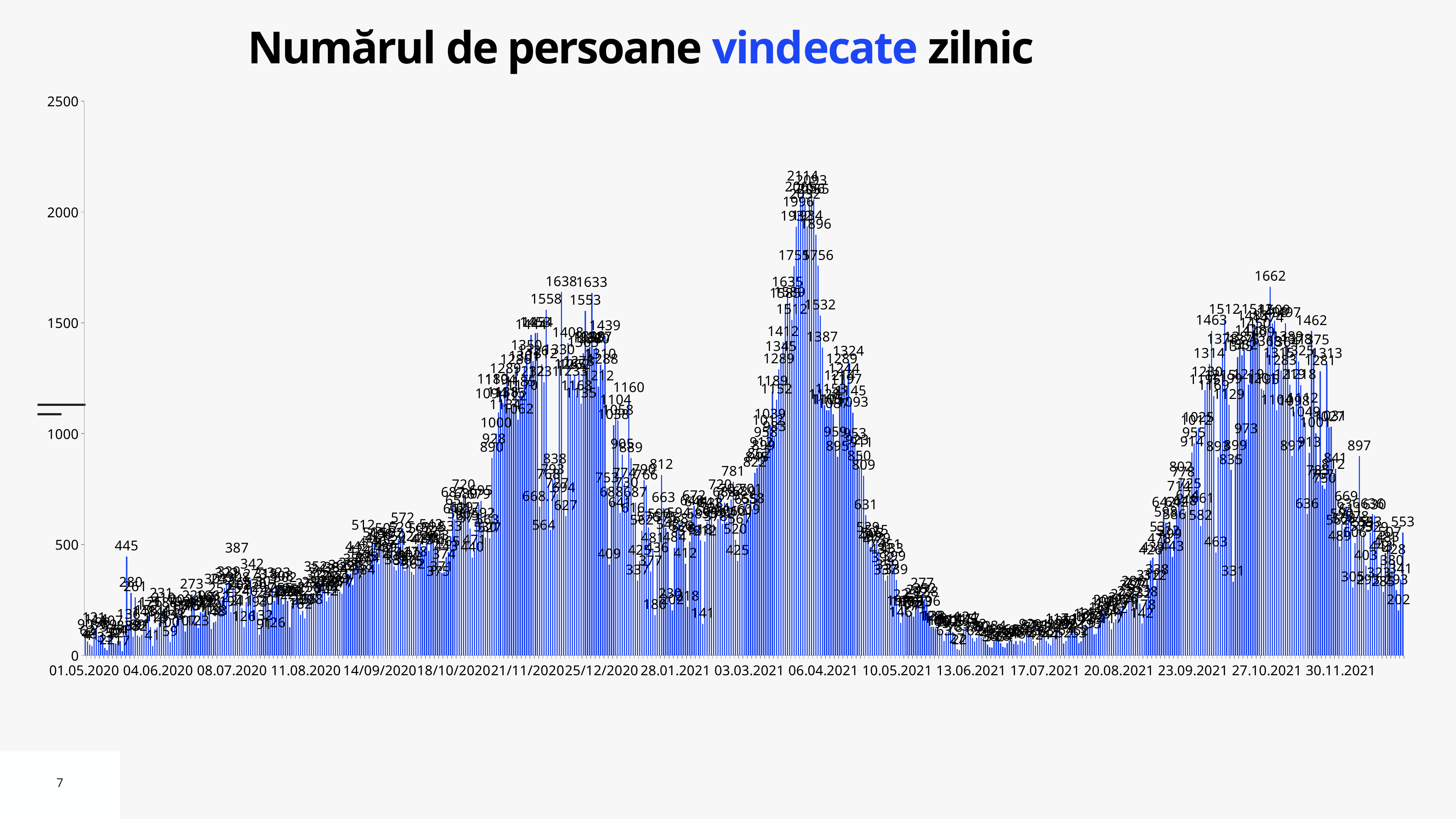
What is the highest value labelled in the wave around 27.10.2021? 1662 Do the values rise or fall between 20.08.2021 and 23.09.2021? rise Is the peak value around 06.04.2021 greater or less than 2000? greater What type of chart is shown on the slide? bar chart Which peak is higher: the one around 06.04.2021 or the one around 21.11.2020? 06.04.2021 What is the highest tick value on the y axis? 2500 What is the highest value labelled on the chart? 2114 How many date labels are shown on the x axis? 18 Are the values between 13.06.2021 and 17.07.2021 greater or less than 500? less What is the highest value labelled in May 2020, shortly after 01.05.2020? 445 Do the values rise or fall between 06.04.2021 and 13.06.2021? fall What is the title of the chart? Numărul de persoane vindecate zilnic